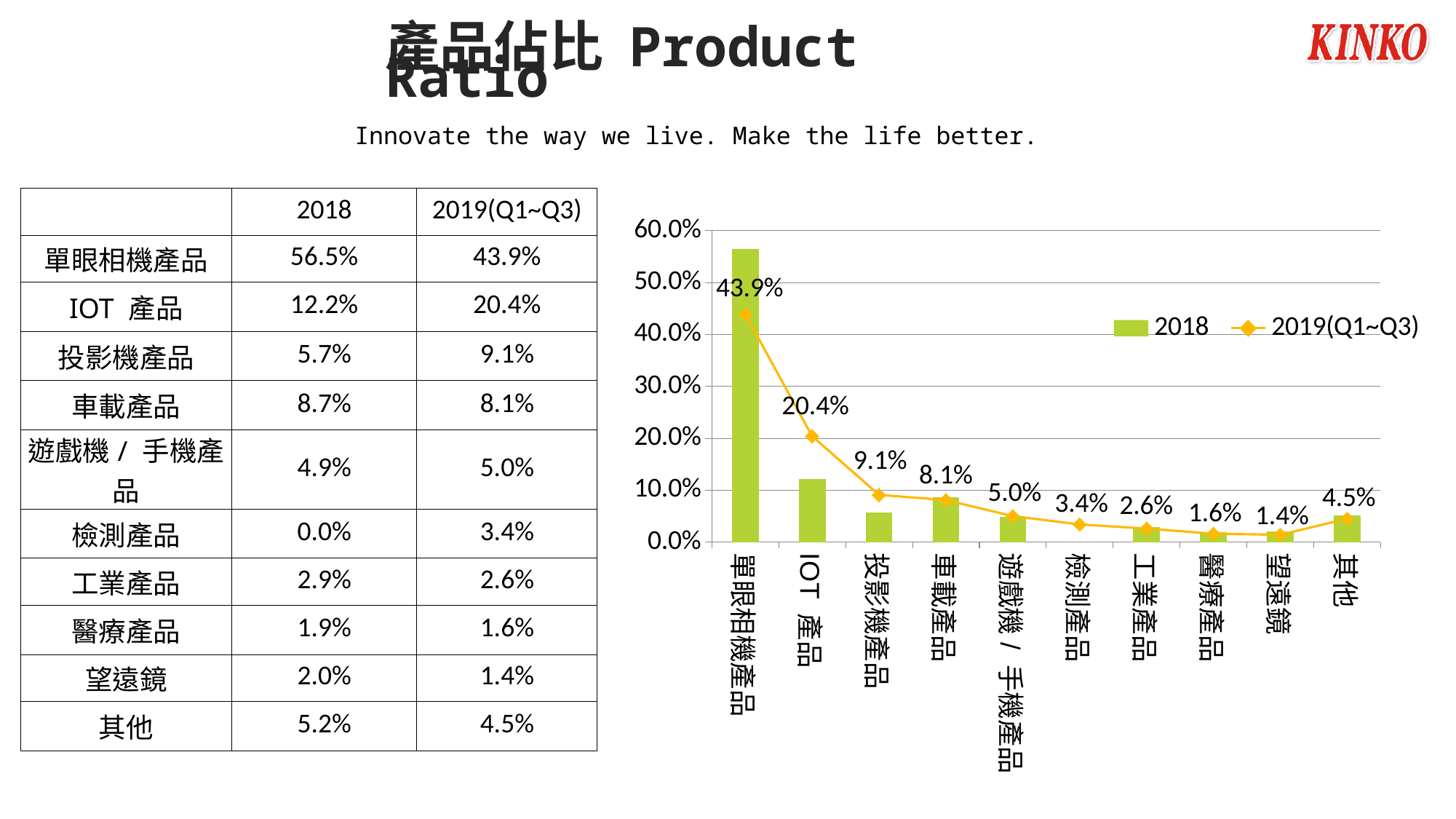
What is the 2019(Q1~Q3) value for 其他 in the chart? 4.5% What is the 2019(Q1~Q3) value for 單眼相機產品 in the chart? 43.9% Is the 2018 bar for IOT 產品 greater or less than 20.0%? less Which category has the highest 2019(Q1~Q3) value in the chart? 單眼相機產品 Is the 2018 bar for 單眼相機產品 greater or less than 50.0%? greater How many product categories are shown on the x axis of the chart? 10 Which has the larger 2019(Q1~Q3) value, 投影機產品 or 車載產品? 投影機產品 How many series does the chart legend list? 2 What is the difference between the 2019(Q1~Q3) values for 單眼相機產品 and IOT 產品? 23.5% What is the 2019(Q1~Q3) value for IOT 產品 in the chart? 20.4% Which category has the lowest 2019(Q1~Q3) value in the chart? 望遠鏡 What kind of chart is shown on the slide? Combined bar and line chart